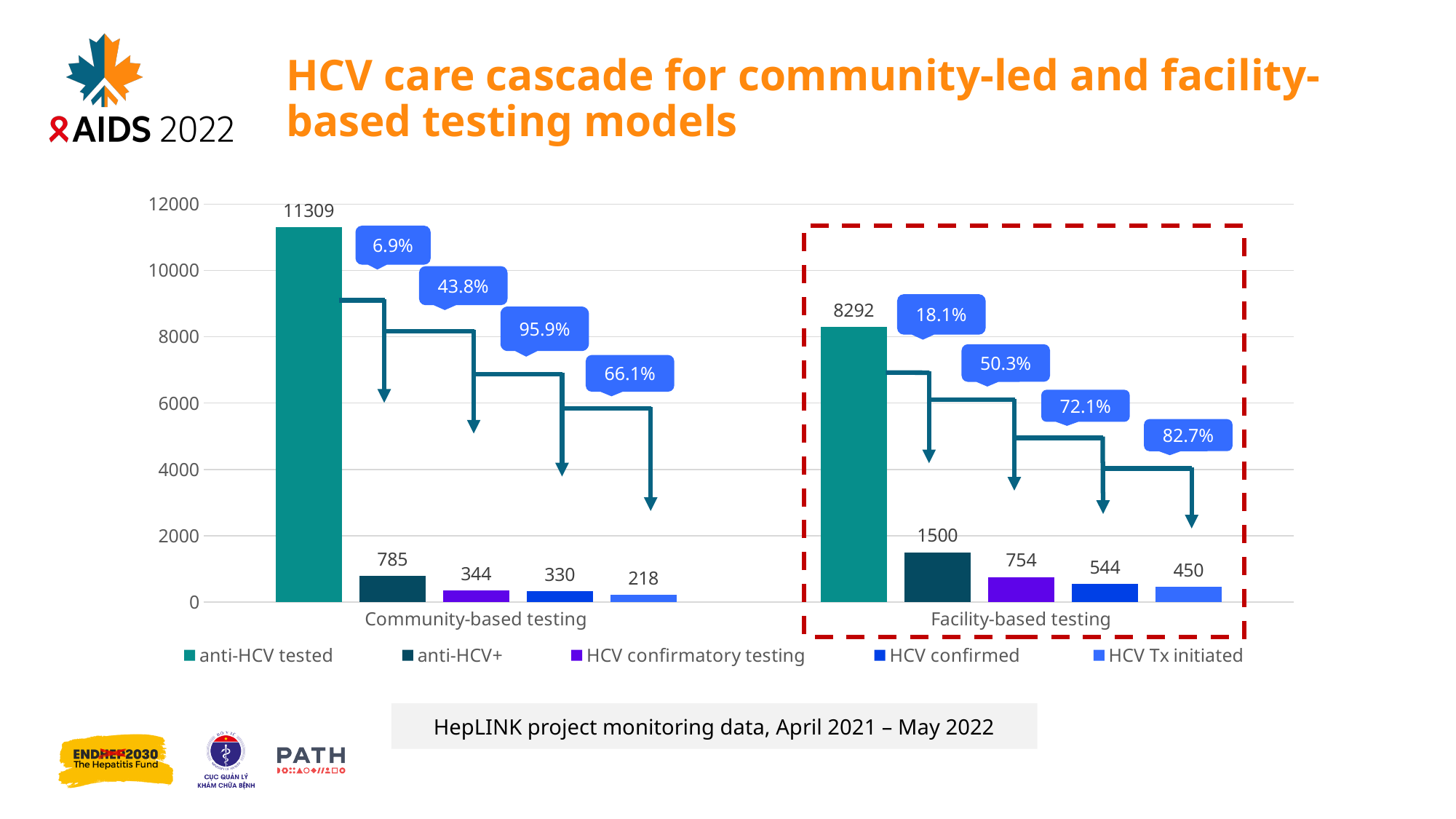
What is the value for HCV confirmatory testing in the facility-based testing model? 754 How many series does the legend list? 5 Which series has the highest value in the facility-based testing model? anti-HCV tested What is the value for anti-HCV+ in the community-based testing model? 785 Which is larger: HCV confirmed in community-based testing or HCV confirmed in facility-based testing? Facility-based testing What kind of chart is shown on the slide? Bar chart What is the value for HCV Tx initiated in the facility-based testing model? 450 Which series has the lowest value in the community-based testing model? HCV Tx initiated How many testing model categories are shown on the x axis? 2 What is the difference between anti-HCV tested in the community-based and facility-based testing models? 3017 How many people were anti-HCV tested in the community-based testing model? 11309 What percentage is shown in the callout between anti-HCV tested and anti-HCV+ for facility-based testing? 18.1%